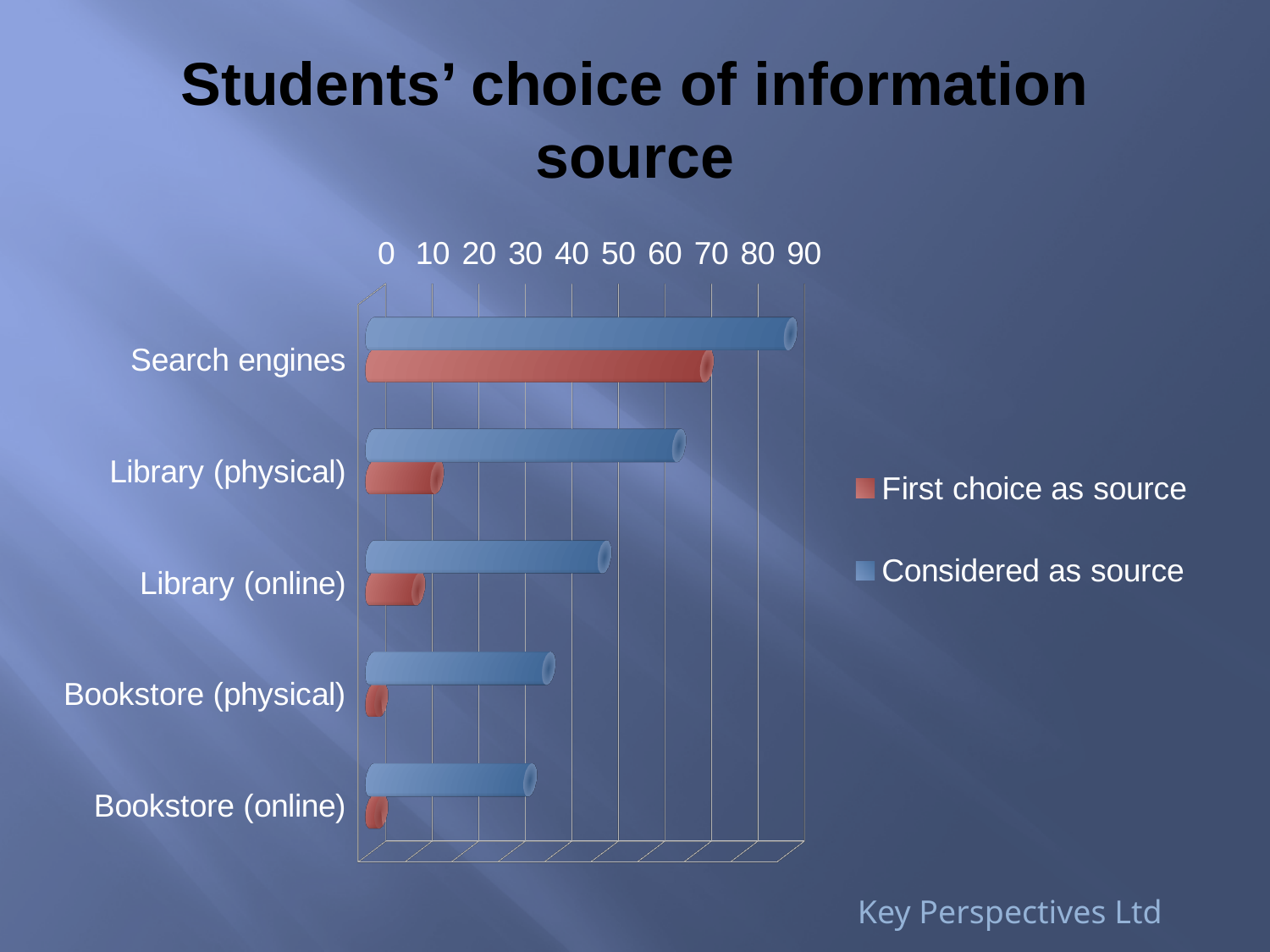
Is the 'Considered as source' value for Library (online) greater or less than 60? less Is the 'First choice as source' value for Bookstore (physical) greater or less than 10? less How many series does the legend list? 2 Which category has the highest value for 'Considered as source'? Search engines How many information source categories are shown on the chart? 5 Which category has the lowest value for 'Considered as source'? Bookstore (online) Is the 'Considered as source' value for Search engines greater or less than 80? greater What kind of chart is shown on the slide? Bar chart Which is larger for 'Considered as source': Library (physical) or Library (online)? Library (physical) What colour represents the 'First choice as source' series? Red Which category has the highest value for 'First choice as source'? Search engines